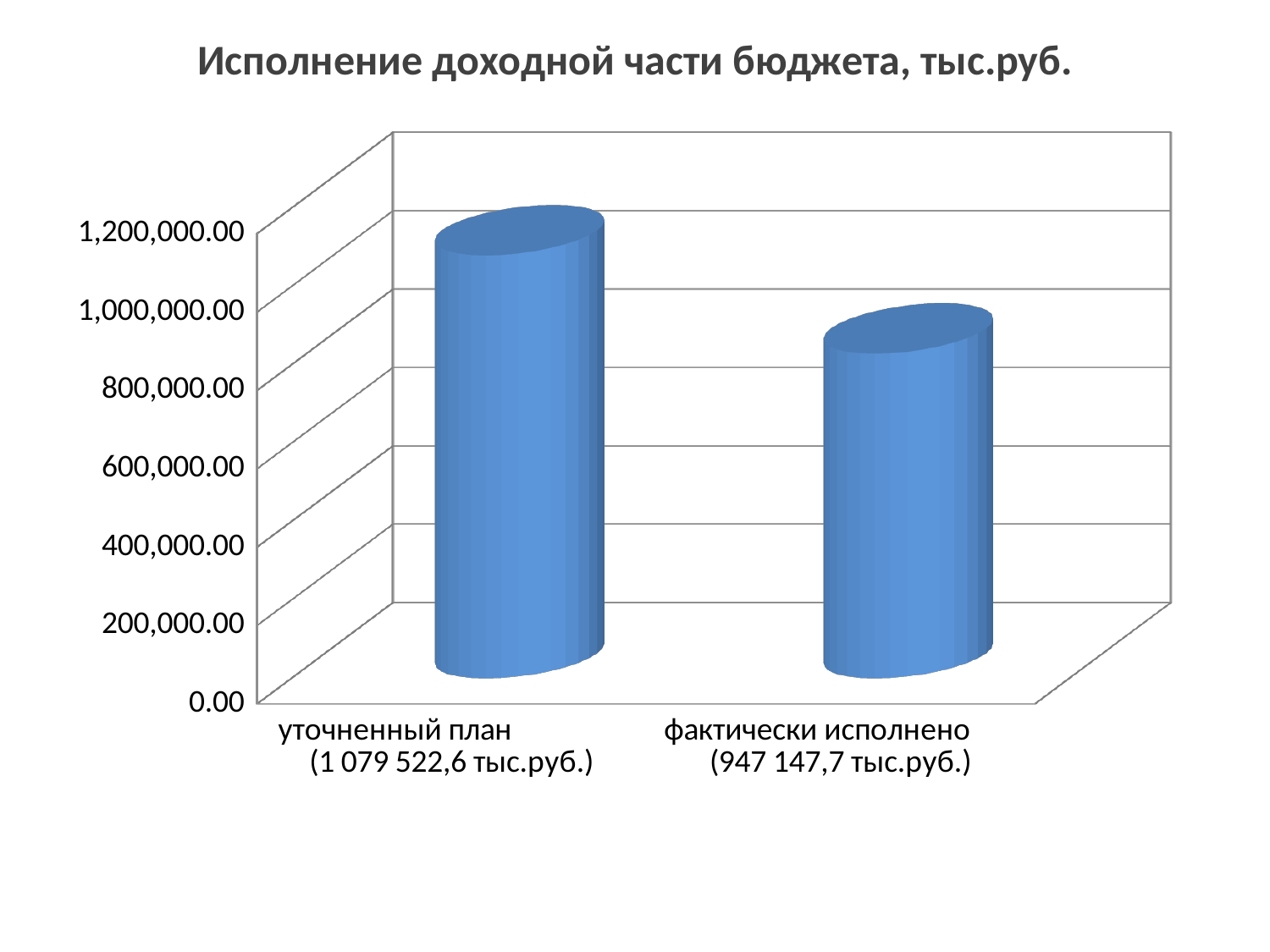
Which category has the lower value? фактически исполнено Is the value for 'уточненный план' greater or less than 1,000,000.00? greater Is the value for 'уточненный план' larger or smaller than the value for 'фактически исполнено'? larger How many categories are shown in the chart? 2 What is the value for 'уточненный план' in the chart? 1 079 522,6 тыс.руб. What is the title of the chart? Исполнение доходной части бюджета, тыс.руб. What is the highest tick value shown on the vertical axis? 1,200,000.00 Which category has the higher value? уточненный план What is the difference between 'уточненный план' and 'фактически исполнено'? 132 374,9 тыс.руб. What kind of chart is shown on the slide? bar chart Is the value for 'фактически исполнено' greater or less than 1,000,000.00? less What is the value for 'фактически исполнено' in the chart? 947 147,7 тыс.руб.